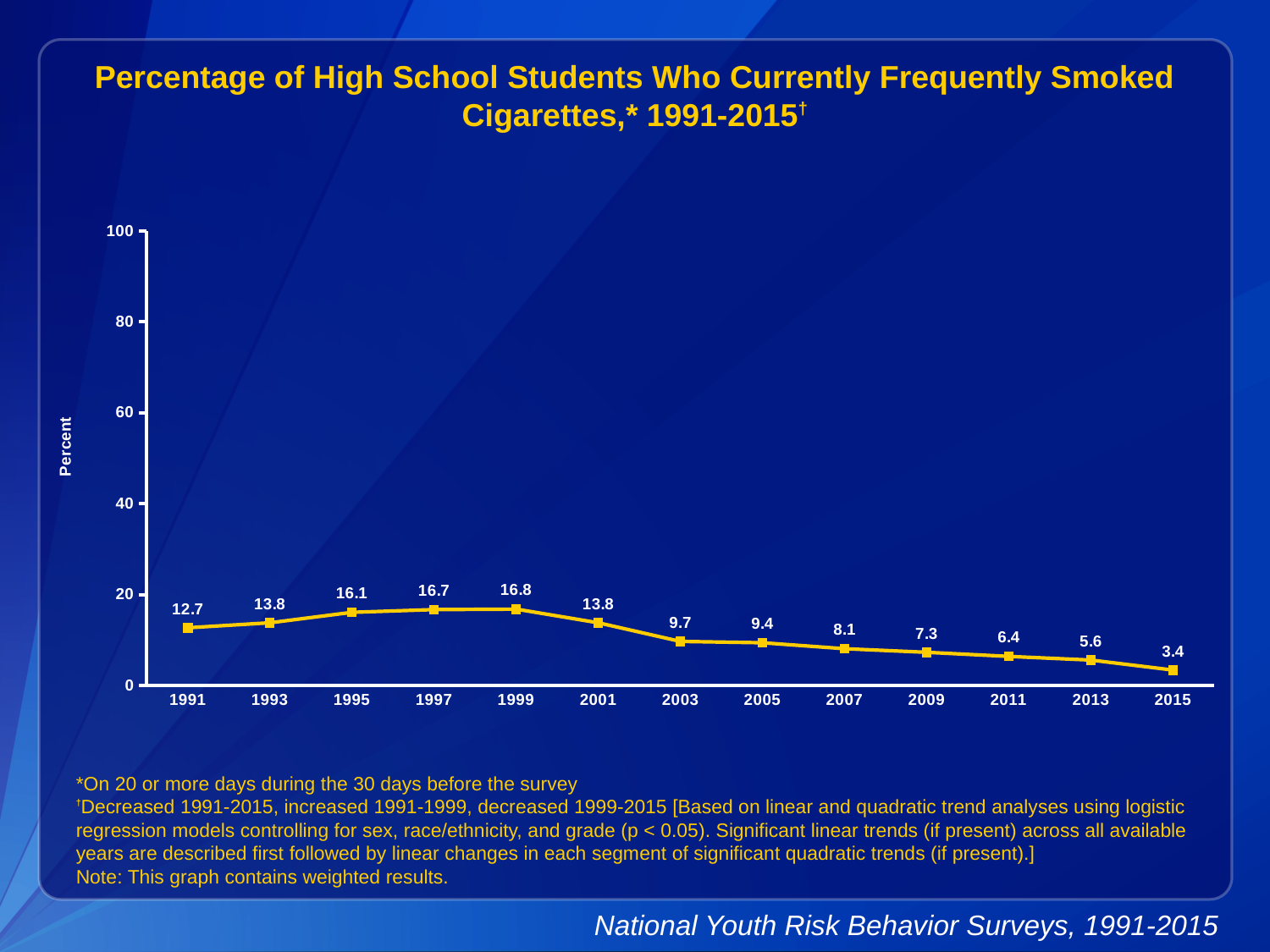
Is the value for 1997 greater or less than 20? less What is the value for 1991? 12.7 Do the values rise or fall from 1999 to 2015? fall What is the label on the y axis? Percent What is the difference between the values for 1999 and 2015? 13.4 Which is larger, the value for 1995 or the value for 2001? 1995 Which year has the highest value? 1999 What kind of chart is shown? line chart Which year has the lowest value? 2015 What is the value for 2003? 9.7 How many years are plotted on the chart? 13 What is the value for 2015? 3.4